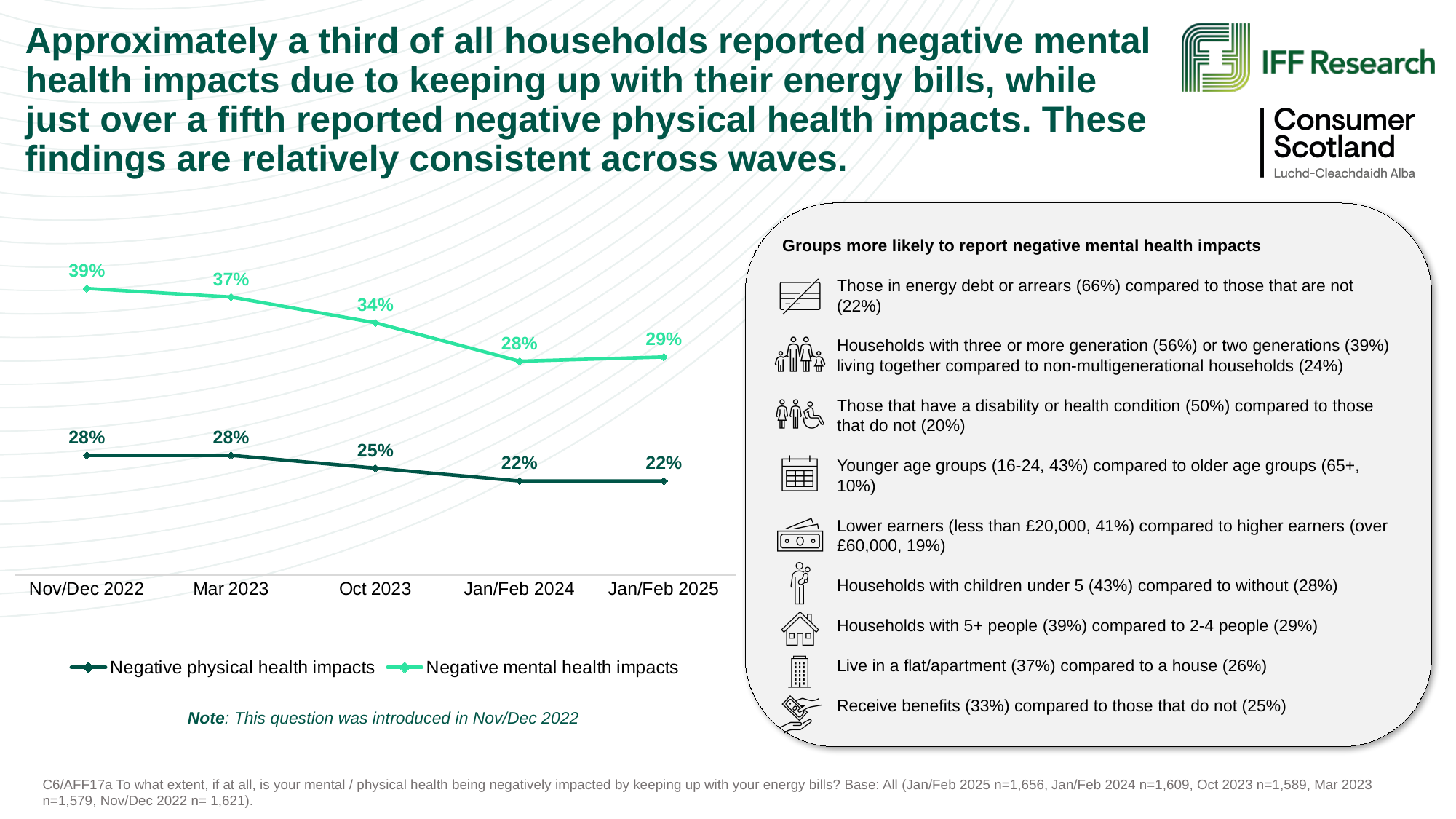
What was the value for Negative mental health impacts in Jan/Feb 2025? 29% How many waves (time points) are plotted on the x axis? 5 What was the value for Negative mental health impacts in Nov/Dec 2022? 39% What was the value for Negative physical health impacts in Oct 2023? 25% In which wave was Negative mental health impacts at its highest? Nov/Dec 2022 Does the Negative physical health impacts series rise or fall from Nov/Dec 2022 to Jan/Feb 2025? Fall According to the note below the chart, when was this question introduced? Nov/Dec 2022 In which wave was Negative mental health impacts at its lowest? Jan/Feb 2024 How many series does the legend list? 2 What is the difference between Negative mental health impacts and Negative physical health impacts in Mar 2023? 9 percentage points Which series had the higher value in Oct 2023, Negative physical health impacts or Negative mental health impacts? Negative mental health impacts What kind of chart is shown on the slide? Line chart